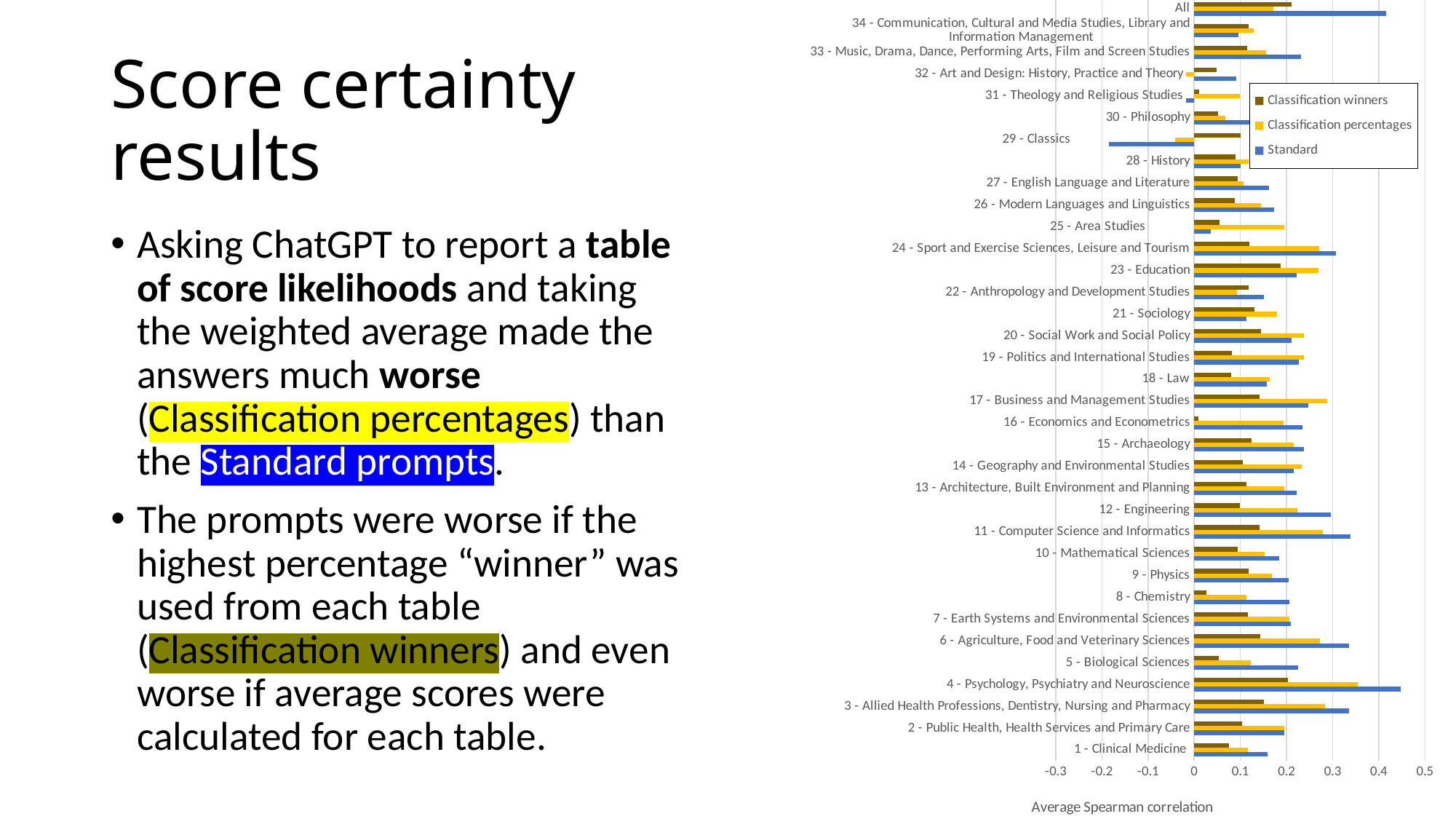
Is the Standard value for "4 - Psychology, Psychiatry and Neuroscience" greater or less than 0.4? greater What are the three series named in the chart legend? Classification winners, Classification percentages, Standard For "25 - Area Studies", which is larger: the Classification percentages value or the Standard value? Classification percentages Is the Standard value for "11 - Computer Science and Informatics" greater or less than 0.3? greater Is the Standard value for "29 - Classics" greater or less than 0? less How many categories are plotted on the chart, including "All"? 35 What kind of chart is shown on the slide? Bar chart How many series does the chart legend list? 3 For "4 - Psychology, Psychiatry and Neuroscience", which is larger: the Standard value or the Classification winners value? Standard Which category has the lowest Standard value? 29 - Classics What is the title of the horizontal axis of the chart? Average Spearman correlation